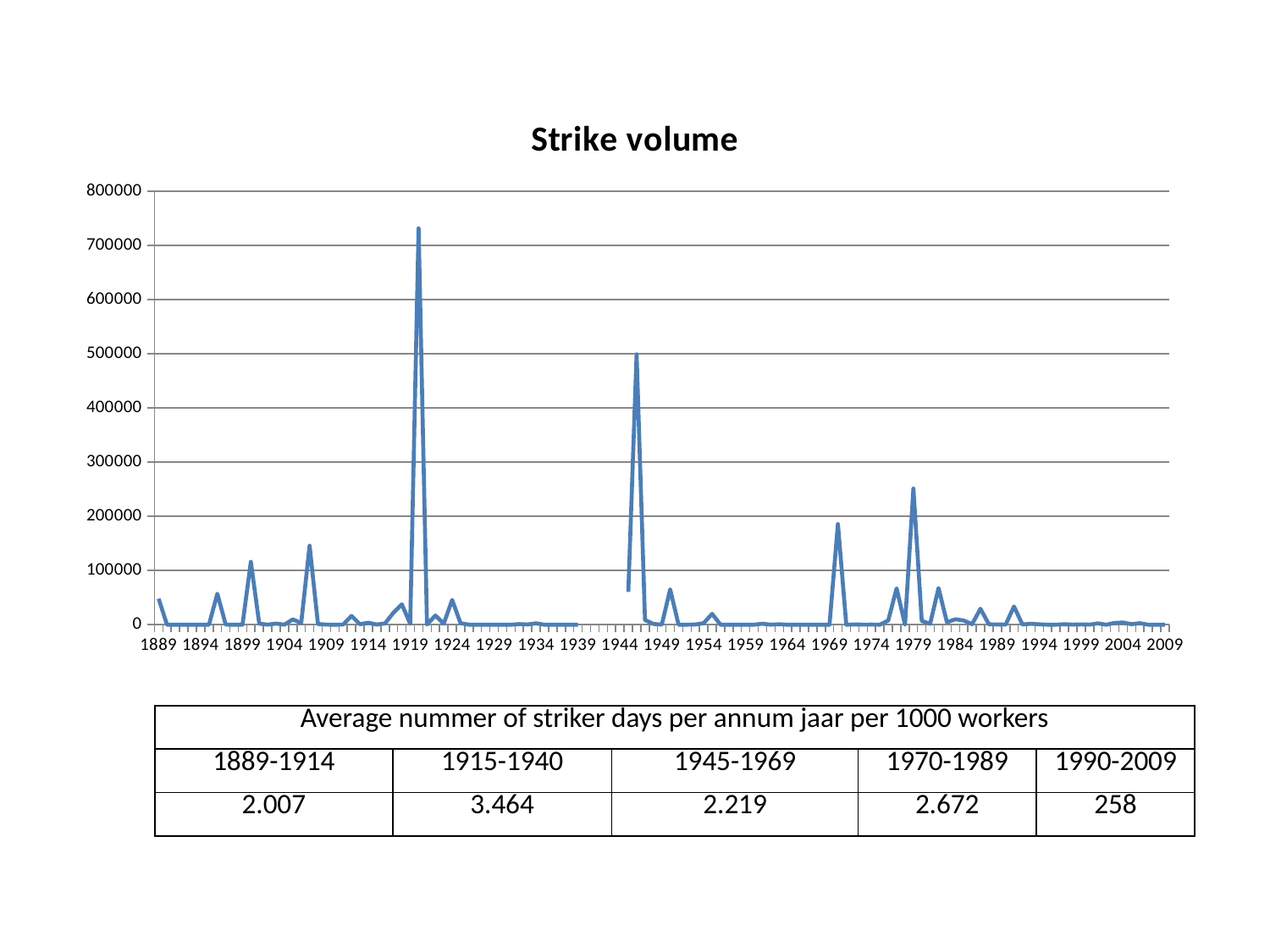
What is the highest value shown on the vertical axis of the chart? 800000 What is the last year labeled on the horizontal axis of the chart? 2009 Are the values in the years after 1994 greater or less than 100000? less Is the peak near the 1979 label greater or less than 200000? greater What kind of chart is shown on the slide? line chart Is the peak that occurs just after the 1944 label greater or less than 400000? greater What is the first year labeled on the horizontal axis of the chart? 1889 What is the title of the chart? Strike volume Which peak is higher: the one near 1919 or the one near 1979? the one near 1919 Is the highest peak of the line located closer to the 1919 label or the 1944 label? 1919